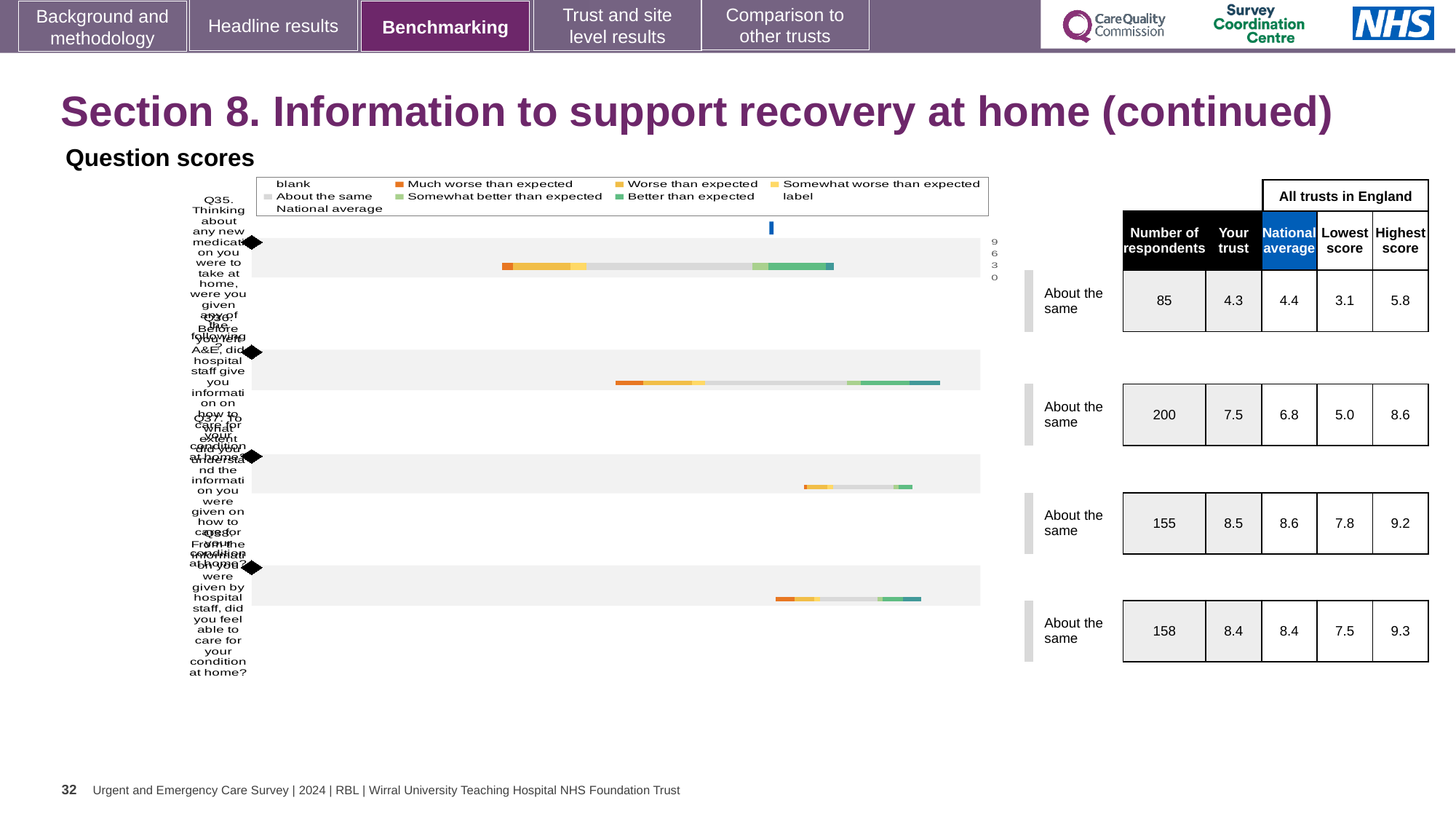
What is the question number of the last (bottom) category in the 'Question scores' chart? Q38 Which legend entry in the 'Question scores' chart is shown in light grey? About the same How many entries does the legend of the 'Question scores' chart list? 9 What kind of chart is shown under the heading 'Question scores'? bar chart Which legend entry in the 'Question scores' chart is shown in dark orange? Much worse than expected What is the question number of the first (top) category in the 'Question scores' chart? Q35 How many questions (categories) are plotted in the 'Question scores' chart? 4